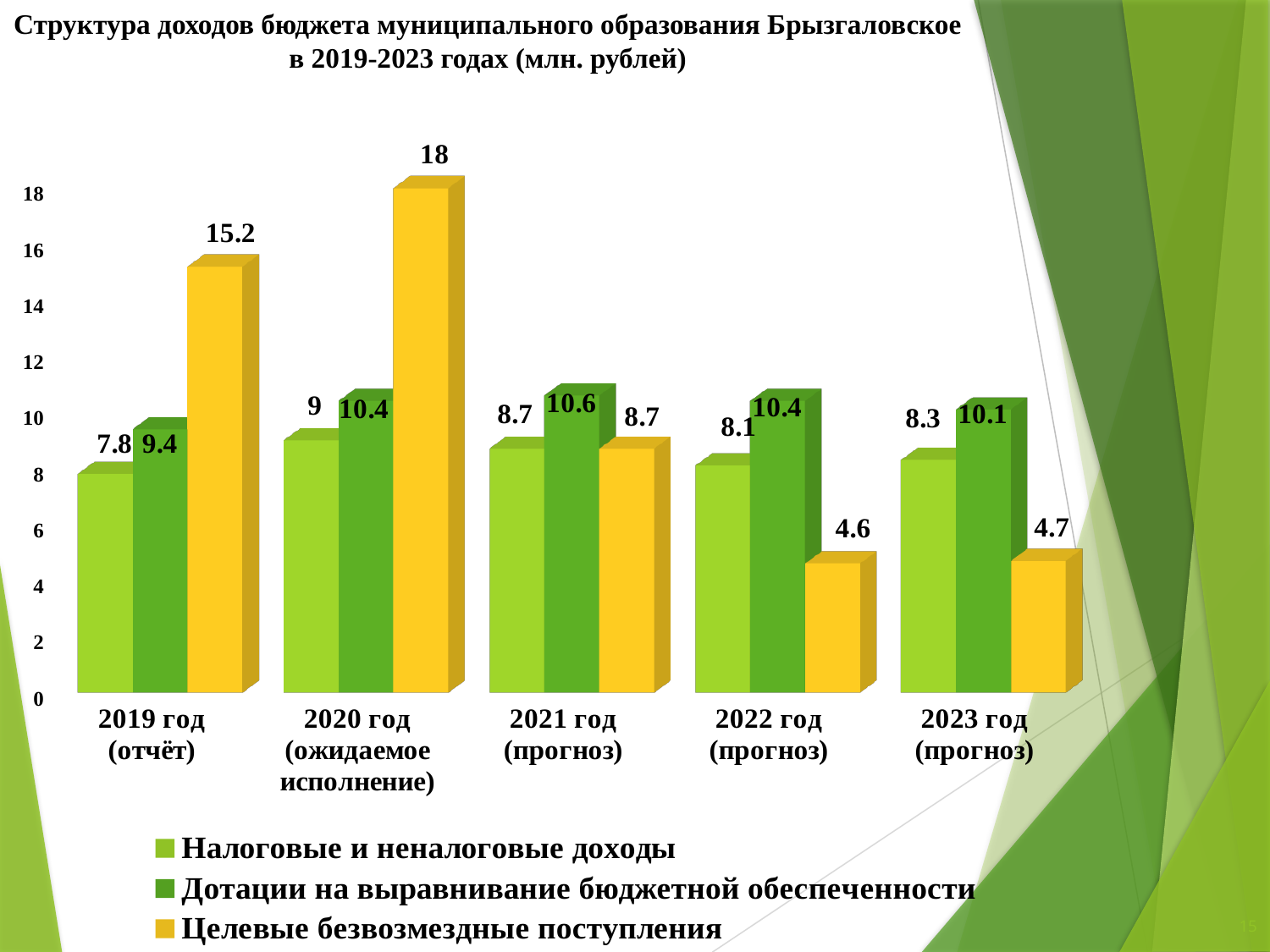
What is the value of Дотации на выравнивание бюджетной обеспеченности for 2023 год (прогноз)? 10.1 How many series does the legend list? 3 What kind of chart is shown on the slide? bar chart In which year is the value of Целевые безвозмездные поступления the lowest? 2022 год (прогноз) Does the value of Целевые безвозмездные поступления rise or fall from 2020 год to 2022 год? fall In which year is the value of Целевые безвозмездные поступления the highest? 2020 год (ожидаемое исполнение) What is the value of Налоговые и неналоговые доходы for 2019 год (отчёт)? 7.8 What is the value of Целевые безвозмездные поступления for 2020 год (ожидаемое исполнение)? 18 Which is larger in 2021 год (прогноз): Налоговые и неналоговые доходы or Дотации на выравнивание бюджетной обеспеченности? Дотации на выравнивание бюджетной обеспеченности What is the difference between Целевые безвозмездные поступления in 2019 год (отчёт) and in 2023 год (прогноз)? 10.5 How many year categories are shown on the x axis? 5 What unit of measurement is stated in the chart title? млн. рублей